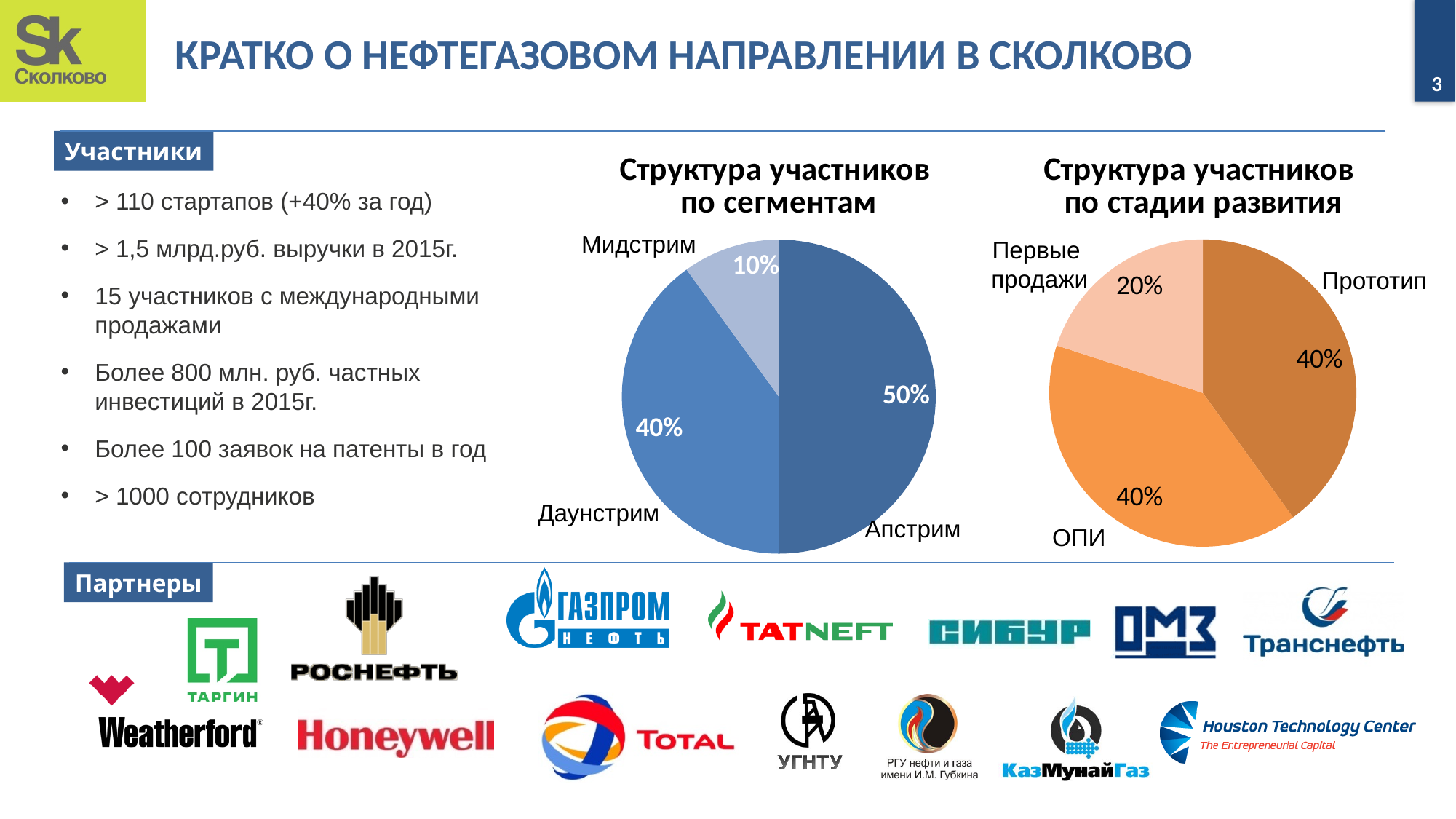
In the chart 'Структура участников по сегментам', which segment has the smallest share? Мидстрим In the chart 'Структура участников по стадии развития', which is larger: the share of ОПИ or the share of Первые продажи? ОПИ In the chart 'Структура участников по стадии развития', which stage has the smallest share? Первые продажи In the chart 'Структура участников по сегментам', how many segments does the pie have? 3 In the chart 'Структура участников по сегментам', what share is labelled for Апстрим? 50% In the chart 'Структура участников по стадии развития', what share is labelled for Прототип? 40% In the chart 'Структура участников по сегментам', what share is labelled for Мидстрим? 10% In the chart 'Структура участников по сегментам', what is the difference between the shares of Даунстрим and Мидстрим? 30% In the chart 'Структура участников по сегментам', which segment has the largest share? Апстрим In the chart 'Структура участников по стадии развития', what share is labelled for Первые продажи? 20% In the chart 'Структура участников по стадии развития', what is the difference between the shares of Прототип and Первые продажи? 20% What type of chart is 'Структура участников по стадии развития'? Pie chart